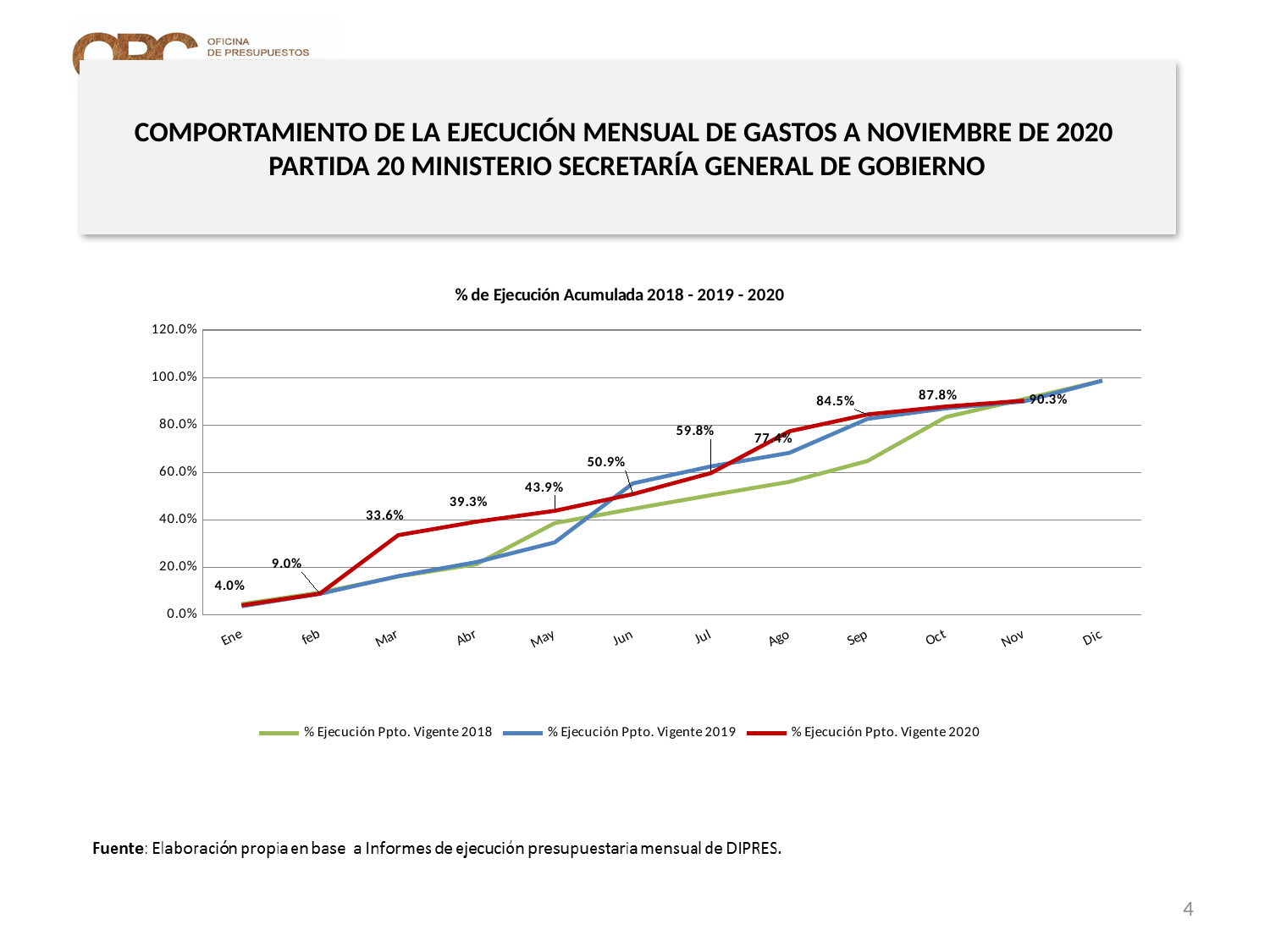
How many series does the legend list? 3 What is the value of % Ejecución Ppto. Vigente 2020 in Ene? 4.0% What is the value of % Ejecución Ppto. Vigente 2020 in Mar? 33.6% What is the title of the chart? % de Ejecución Acumulada 2018 - 2019 - 2020 What is the value of % Ejecución Ppto. Vigente 2020 in Jun? 50.9% What kind of chart is shown on the slide? line chart What is the difference between the 2020 values for Mar and Feb? 24.6% What is the value of % Ejecución Ppto. Vigente 2020 in Nov? 90.3% Is the value for % Ejecución Ppto. Vigente 2019 in Sep greater or less than 60.0%? greater What is the difference between the 2020 values for Sep and Ago? 7.1% Is the value for % Ejecución Ppto. Vigente 2018 in Oct greater or less than 100.0%? less Does the % Ejecución Ppto. Vigente 2020 series rise or fall from Ene to Nov? rise